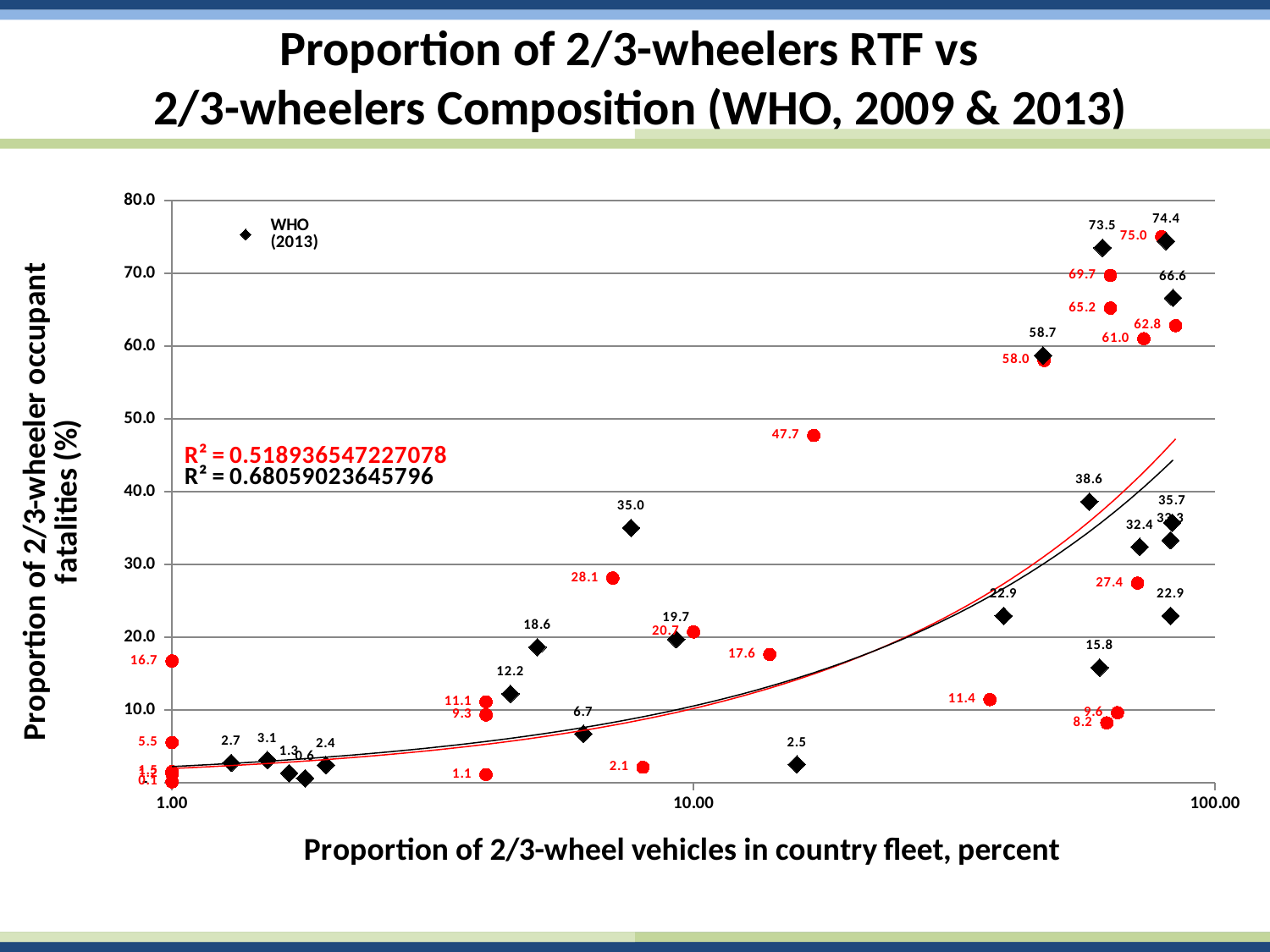
What is the title of the chart? Proportion of 2/3-wheelers RTF vs 2/3-wheelers Composition (WHO, 2009 & 2013) Is the red circle point labeled 47.7 greater or less than 40.0 on the y axis? greater What is the label of the x axis? Proportion of 2/3-wheel vehicles in country fleet, percent What kind of chart is shown on the slide? Scatter chart How many series does the legend list? 1 Do the fitted trend lines rise or fall as the proportion of 2/3-wheel vehicles increases along the x axis? Rise Which is larger: the red point labeled 47.7 or the black diamond labeled 35.0? The red point labeled 47.7 What is the highest labeled value among the black WHO (2013) diamond points? 74.4 What is the highest labeled value among the red circle points? 75.0 What is the R² value shown in red for the red trend line? 0.518936547227078 What is the difference between the highest black diamond value (74.4) and the next highest black diamond value (73.5)? 0.9 What is the R² value shown in black for the black trend line? 0.68059023645796